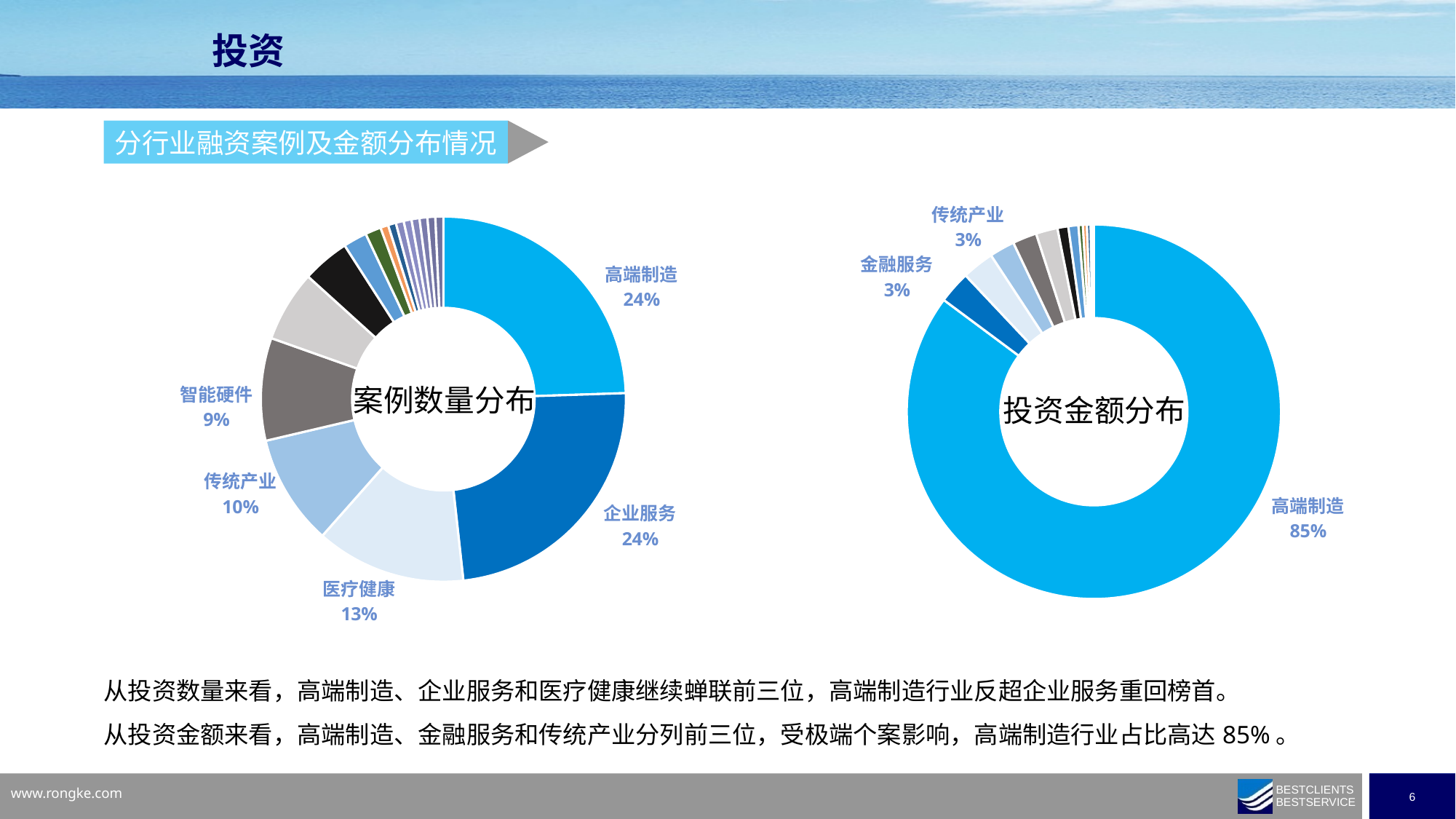
What is the difference between the share of 高端制造 in the 投资金额分布 chart and its share in the 案例数量分布 chart? 61% In the 案例数量分布 chart, which is larger, 医疗健康 or 智能硬件? 医疗健康 In the 案例数量分布 chart, what share does 医疗健康 have? 13% In the 案例数量分布 chart, what share does 高端制造 have? 24% In the 投资金额分布 chart, which category has the largest share? 高端制造 In the 案例数量分布 chart, what share does 智能硬件 have? 9% In the 案例数量分布 chart, what share does 传统产业 have? 10% What is the title shown in the centre of the left chart? 案例数量分布 In the 投资金额分布 chart, what share does 高端制造 have? 85% In the 案例数量分布 chart, what is the difference between the shares of 企业服务 and 医疗健康? 11% What kind of chart is the 投资金额分布 chart? Pie (donut) chart In the 投资金额分布 chart, what share does 金融服务 have? 3%